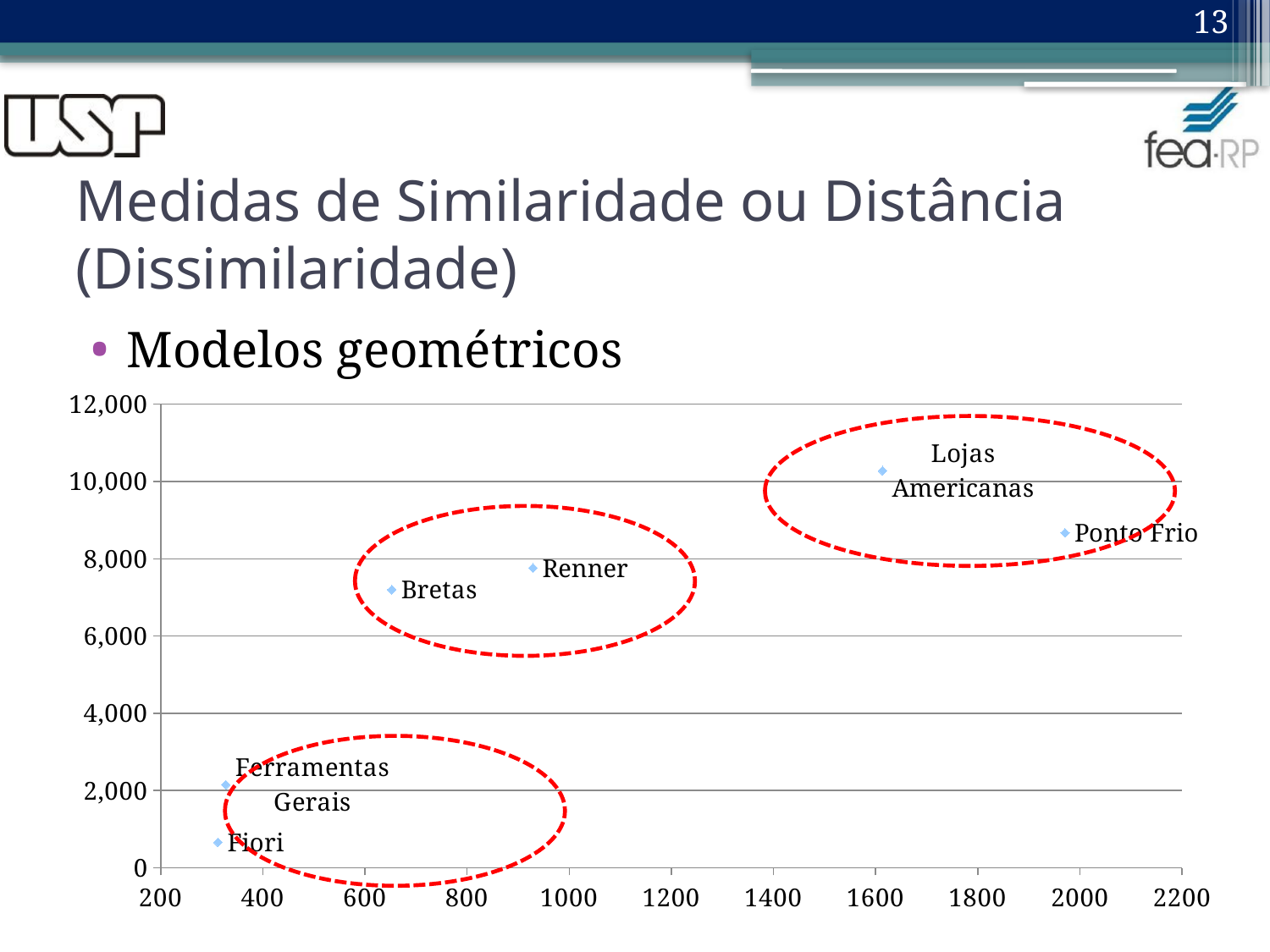
Is the horizontal-axis value for Ponto Frio greater or less than 1800? greater How many data points are plotted on the chart? 6 Do the plotted values generally rise or fall as the horizontal-axis value increases? rise Which point has the highest value on the vertical axis? Lojas Americanas How many red dashed ellipses group the points on the chart? 3 Which has the higher vertical-axis value, Renner or Bretas? Renner Is the vertical-axis value for Bretas greater or less than 8,000? less Which point has the highest value on the horizontal axis? Ponto Frio Is the vertical-axis value for Fiori greater or less than 2,000? less What kind of chart is shown on the slide? scatter chart Which point has the lowest value on the vertical axis? Fiori